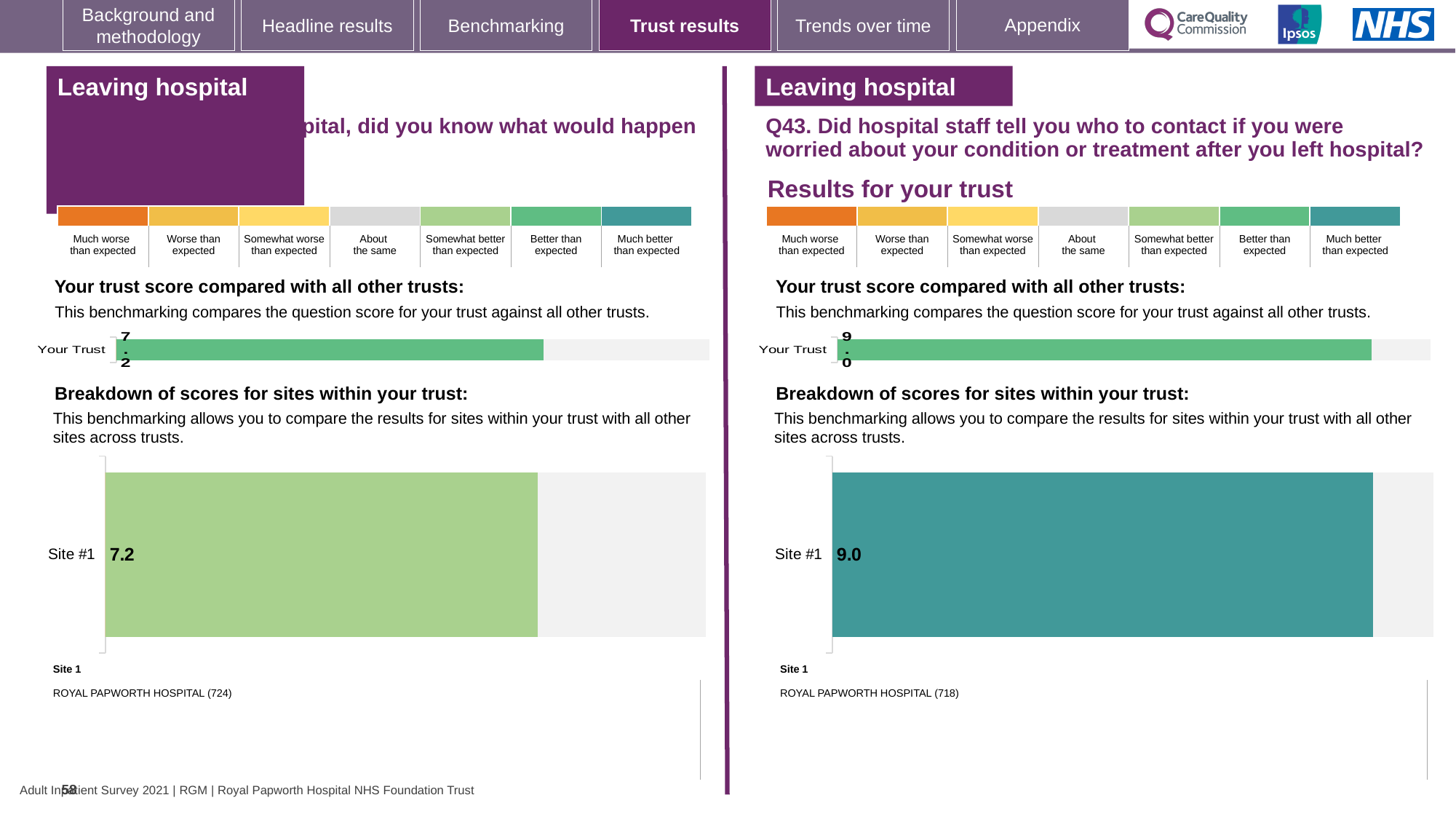
What is the name of the site listed as Site 1 below the breakdown chart on the left-hand side of the slide? ROYAL PAPWORTH HOSPITAL (724) How many sites are shown in the 'Breakdown of scores for sites within your trust' chart on the left-hand side of the slide? 1 Is the Your Trust value in the left-hand 'Your trust score compared with all other trusts' chart greater or less than the Your Trust value in the right-hand (Q43) chart? less What is the name of the site listed as Site 1 below the breakdown chart on the right-hand side of the slide (Q43)? ROYAL PAPWORTH HOSPITAL (718) How many sites are shown in the 'Breakdown of scores for sites within your trust' chart on the right-hand side of the slide (Q43)? 1 Which is larger: the Site #1 score in the left-hand breakdown chart or the Site #1 score in the right-hand (Q43) breakdown chart? The right-hand (Q43) chart In the 'Breakdown of scores for sites within your trust' chart on the right-hand side of the slide (Q43), what score is shown for Site #1? 9.0 What is the difference between the Site #1 score in the right-hand (Q43) breakdown chart and the Site #1 score in the left-hand breakdown chart? 1.8 In the 'Breakdown of scores for sites within your trust' chart on the left-hand side of the slide, what score is shown for Site #1? 7.2 On the left-hand side of the slide, what is the value shown for Your Trust in the 'Your trust score compared with all other trusts' chart? 7.2 On the right-hand side of the slide (Q43), what is the value shown for Your Trust in the 'Your trust score compared with all other trusts' chart? 9.0 What type of chart is used for the 'Breakdown of scores for sites within your trust' on the right-hand side of the slide (Q43)? Bar chart